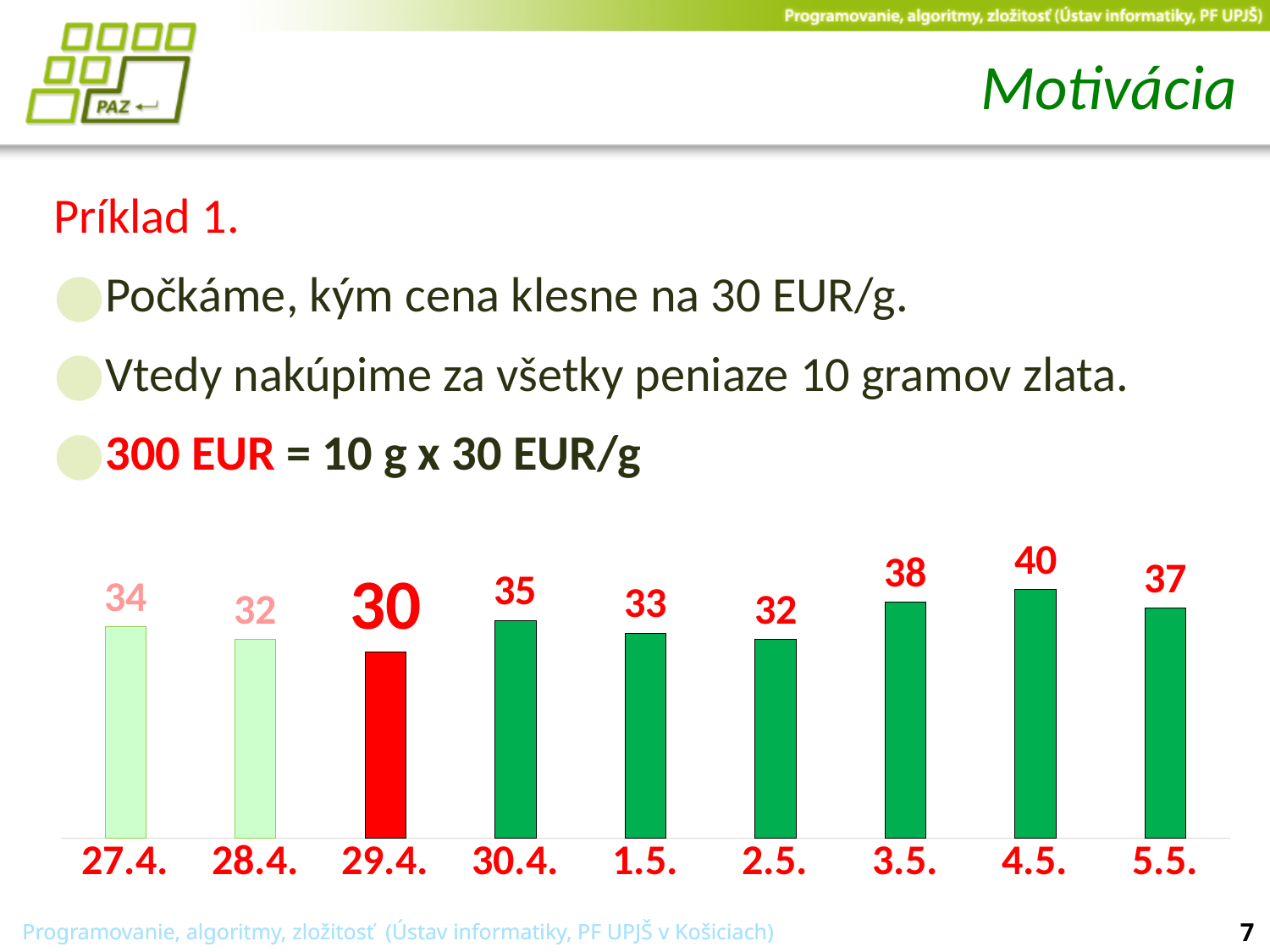
Do the values rise or fall from 29.4. to 30.4.? rise What is the difference between the values for 4.5. and 29.4.? 10 What is the difference between the values for 30.4. and 1.5.? 2 Which is larger, the value for 28.4. or the value for 5.5.? 5.5. What is the value shown for 27.4.? 34 Which bar is coloured red? 29.4. Which date has the lowest value? 29.4. What kind of chart is this? bar chart What is the value shown for 29.4.? 30 Which date has the highest value? 4.5. What is the value shown for 3.5.? 38 How many dates are shown on the x axis? 9